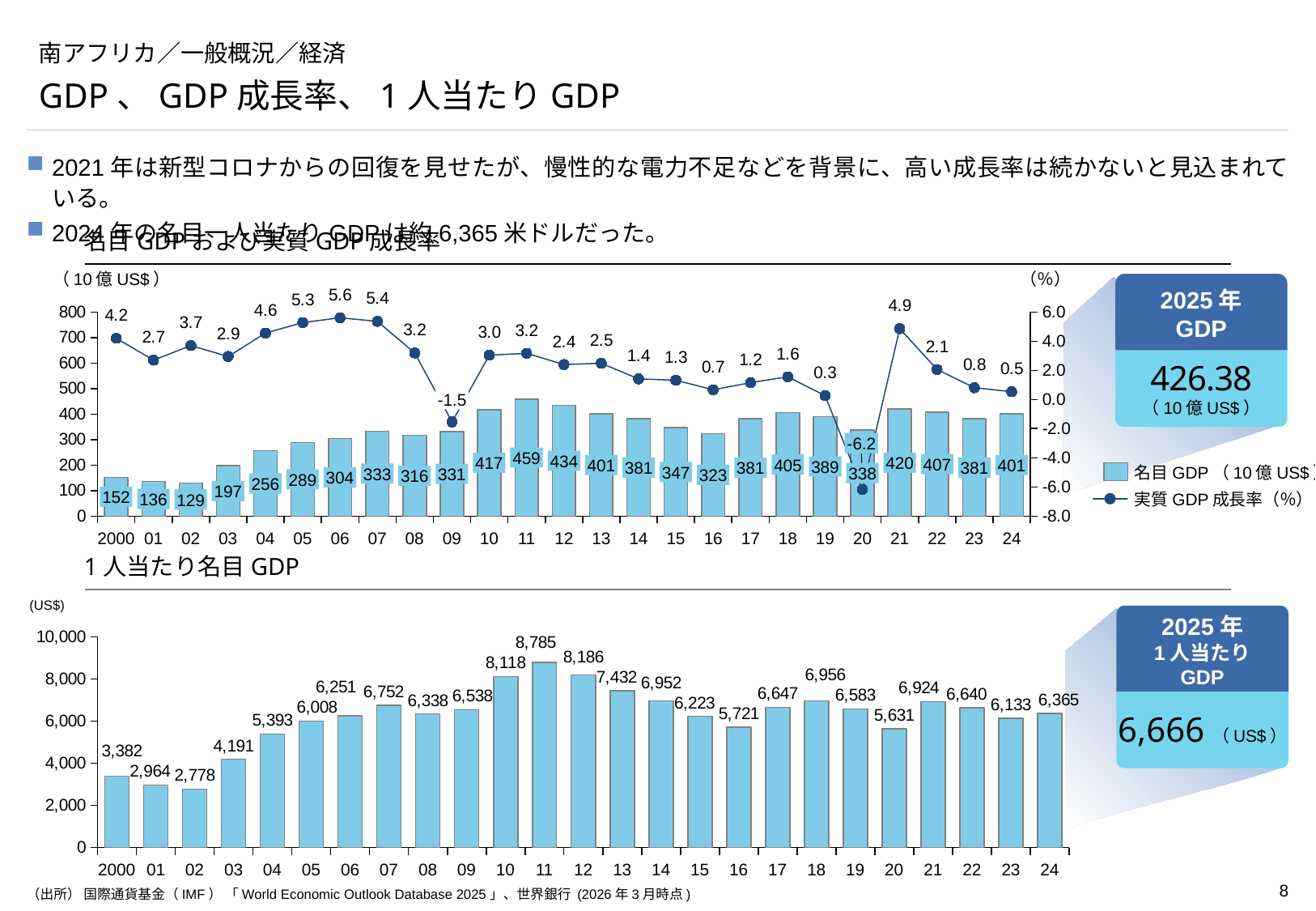
What kind of chart is the bottom chart (1人当たり名目GDP)? bar chart In the top chart (名目GDPおよび実質GDP成長率), what is the nominal GDP value for 2011? 459 In the bottom chart, how many years are plotted on the x axis? 25 In the bottom chart, which year has the lowest per capita nominal GDP? 02 In the top chart, what is the difference between the nominal GDP for 2021 and 2020? 82 In the top chart, which year has the highest nominal GDP bar? 11 In the top chart, what is the real GDP growth rate for 2020? -6.2 In the bottom chart, which year has the highest per capita nominal GDP? 11 In the top chart, how many series does the legend list? 2 In the top chart, which year has the lowest real GDP growth rate? 20 In the bottom chart, is the per capita nominal GDP for 2010 larger or smaller than that for 2013? larger In the bottom chart (1人当たり名目GDP), what is the per capita nominal GDP for 2024? 6,365